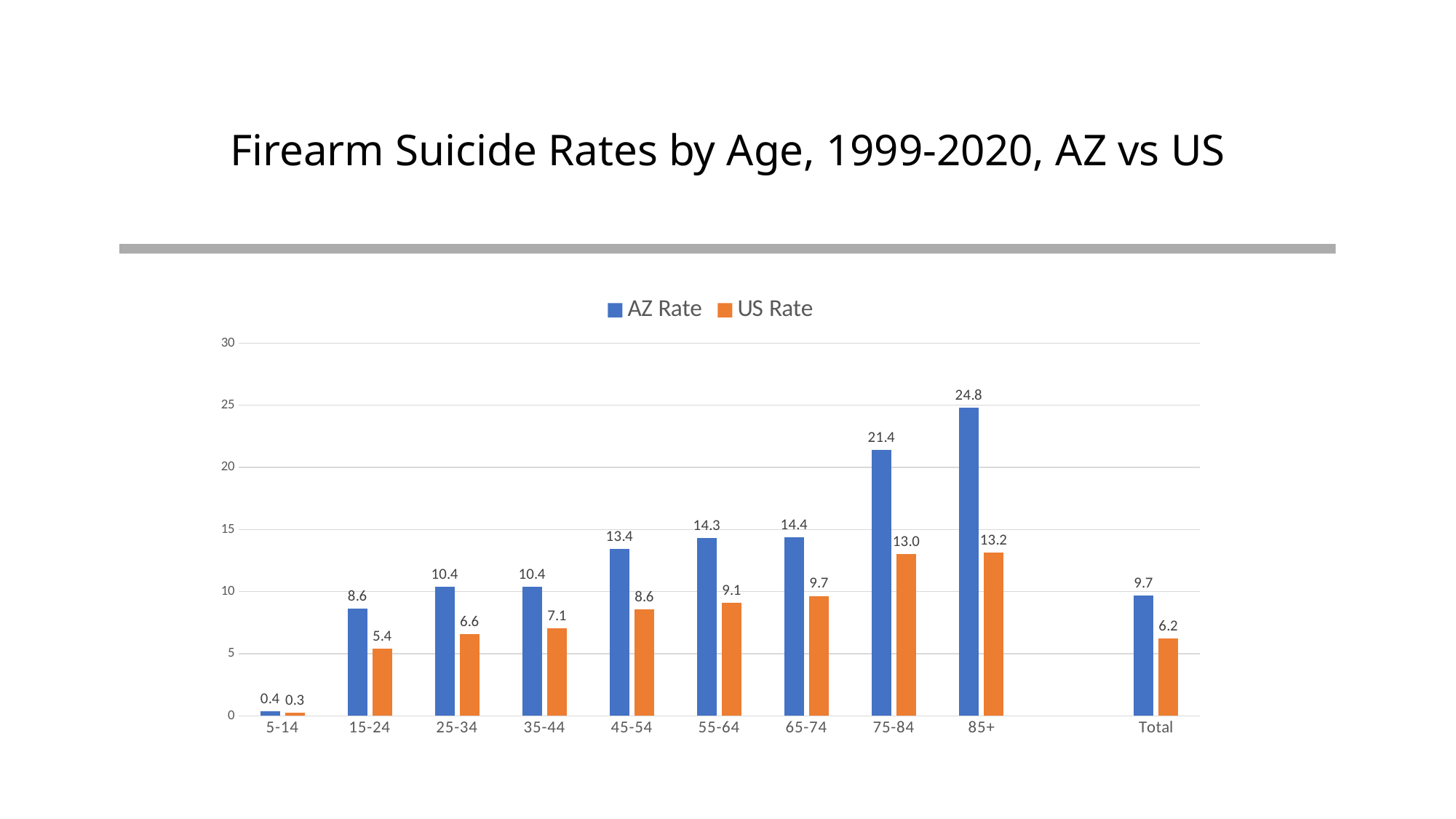
Do the AZ Rate values rise or fall from the 45-54 age group to the 85+ age group? Rise What is the difference between the AZ Rate and the US Rate for the 75-84 age group? 8.4 What is the AZ Rate for the Total category? 9.7 How many series does the legend list? 2 Which age group has the lowest AZ Rate? 5-14 Which age group has the highest US Rate? 85+ How many age-group categories (including Total) are shown on the x axis? 10 Which is larger, the AZ Rate for 55-64 or the AZ Rate for 65-74? AZ Rate for 65-74 What kind of chart is shown on the slide? Bar chart What is the US Rate for the 45-54 age group? 8.6 What is the AZ Rate for the 85+ age group? 24.8 What colour represents the US Rate series? Orange